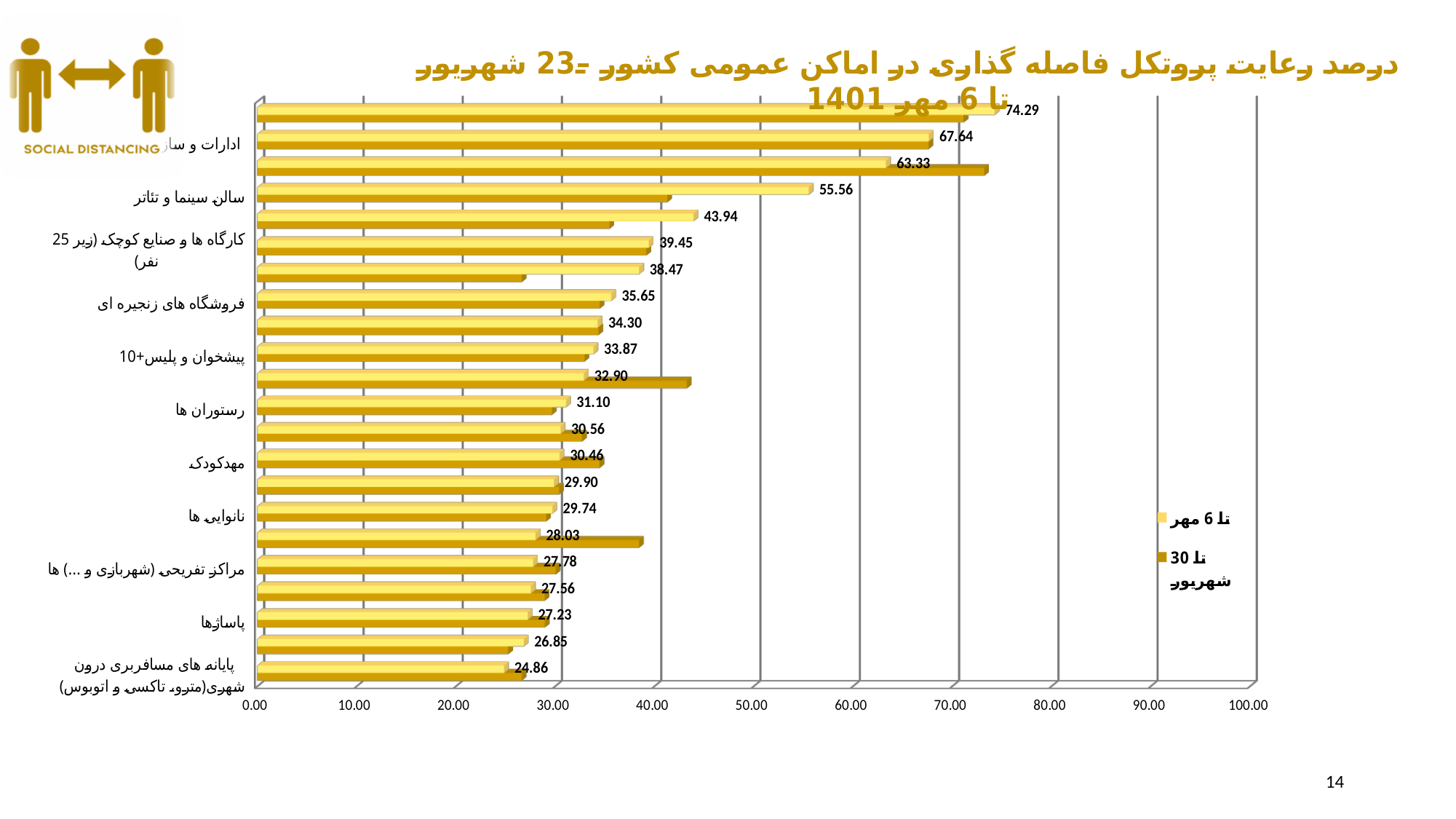
What are the two series named in the legend? تا 6 مهر and تا 30 شهریور What is the highest value labelled for the تا 6 مهر series? 74.29 What is the تا 6 مهر value for نانوایی ها? 29.74 Which category has the lowest labelled value for the تا 6 مهر series? پایانه های مسافربری درون شهری (مترو، تاکسی و اتوبوس) What is the تا 6 مهر value for پاساژها? 27.23 What is the تا 6 مهر value for سالن سینما و تئاتر? 55.56 What kind of chart is shown on the slide? bar chart Which has the larger تا 6 مهر value, فروشگاه های زنجیره ای or مهدکودک? فروشگاه های زنجیره ای Is the تا 30 شهریور value for پیشخوان و پلیس+10 greater or less than 30.00? greater How many series does the legend list? 2 What is the difference between the تا 6 مهر values for سالن سینما و تئاتر and رستوران ها? 24.46 What is the تا 6 مهر value for رستوران ها? 31.10